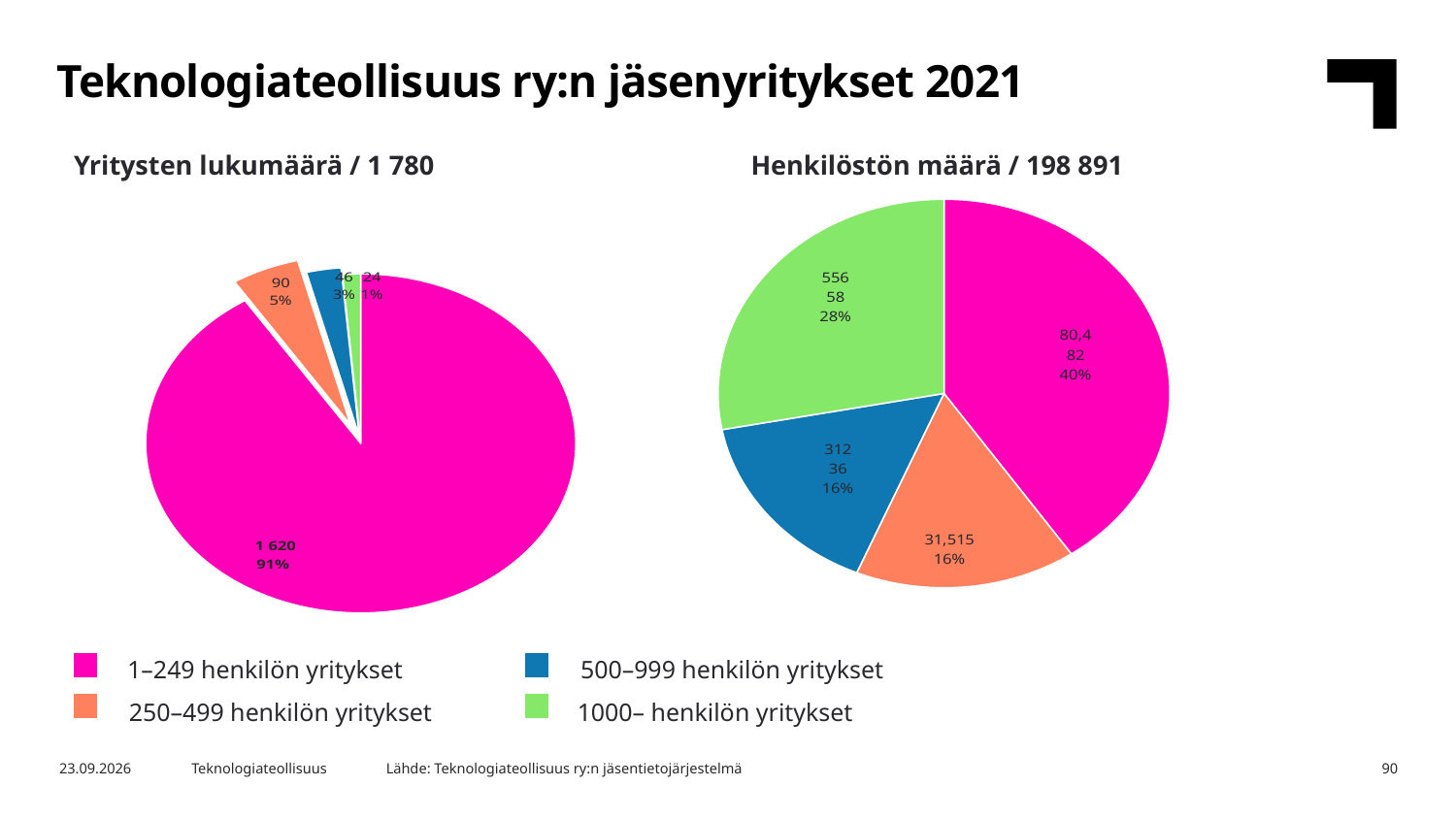
In the right chart "Henkilöstön määrä / 198 891", which category has the largest slice? 1–249 henkilön yritykset In the right chart "Henkilöstön määrä / 198 891", what percentage share do 1–249 henkilön yritykset have? 40% What kind of chart is the left chart titled "Yritysten lukumäärä / 1 780"? pie chart In the left chart "Yritysten lukumäärä / 1 780", what is the value for 1000– henkilön yritykset? 24 In the left chart "Yritysten lukumäärä / 1 780", which category has the smallest slice? 1000– henkilön yritykset In the left chart "Yritysten lukumäärä / 1 780", what percentage share do 1–249 henkilön yritykset have? 91% How many categories does the legend list? 4 How many slices does the right chart "Henkilöstön määrä / 198 891" have? 4 In the left chart "Yritysten lukumäärä / 1 780", what is the difference between the values for 250–499 and 500–999 henkilön yritykset? 44 In the left chart "Yritysten lukumäärä / 1 780", what is the value for 250–499 henkilön yritykset? 90 In the left chart "Yritysten lukumäärä / 1 780", what is the value for 1–249 henkilön yritykset? 1 620 In the left chart "Yritysten lukumäärä / 1 780", what is the value for 500–999 henkilön yritykset? 46